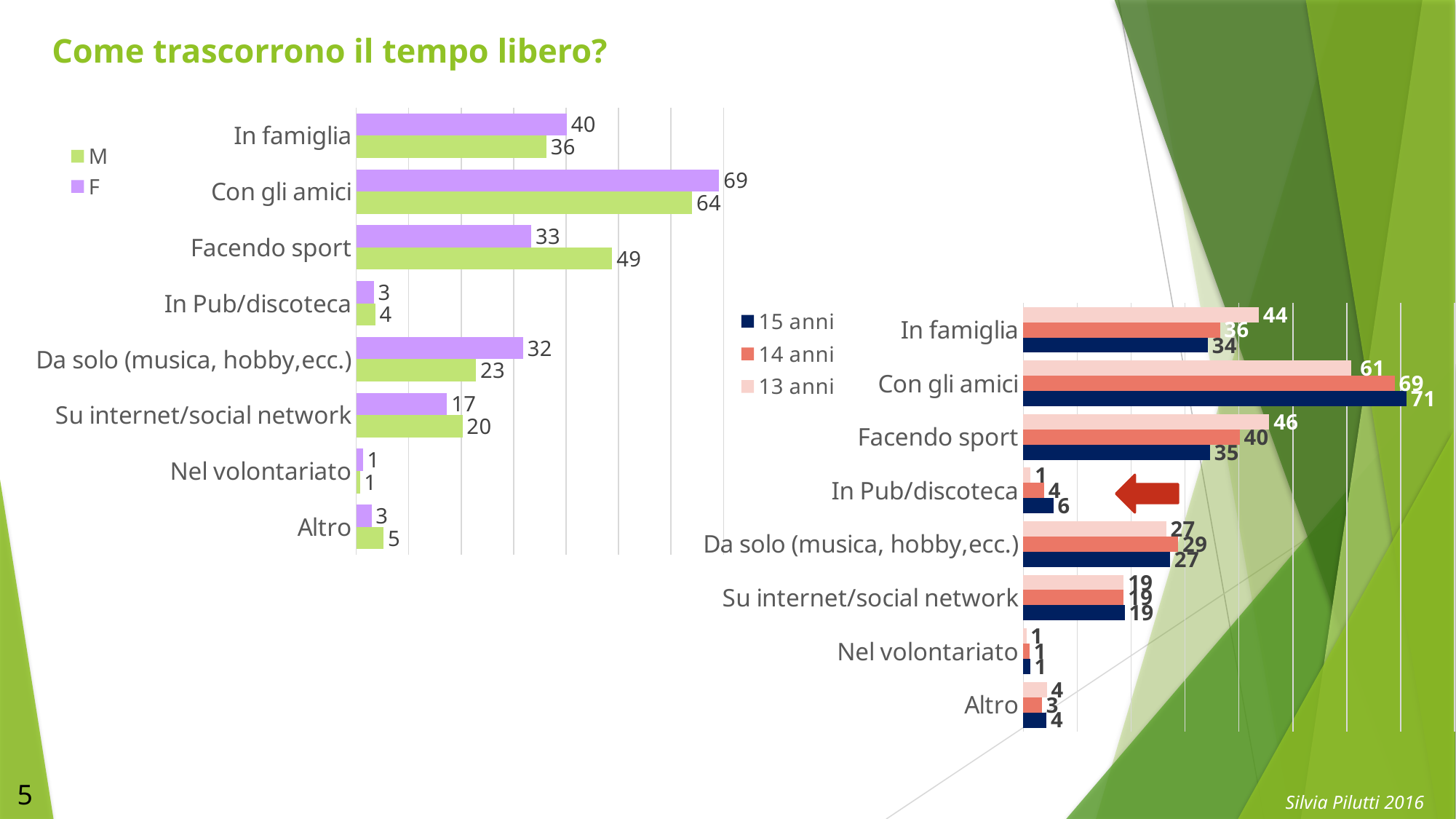
In the left chart, which is larger for 'Su internet/social network', M or F? M In the right chart, what is the value for 15 anni for 'Con gli amici'? 71 In the left chart, what is the value for F for 'Facendo sport'? 33 In the right chart, what is the value for 13 anni for 'In famiglia'? 44 How many series does the legend of the left chart list? 2 What type of chart is the right chart? Bar chart In the right chart, which age group has the highest value for 'Facendo sport'? 13 anni In the left chart, what is the difference between M and F for 'Facendo sport'? 16 In the left chart, which category has the highest value for F? Con gli amici How many categories does the right chart show? 8 In the left chart, what is the value for M for 'Da solo (musica, hobby,ecc.)'? 23 In the right chart, what is the difference between 15 anni and 13 anni for 'In Pub/discoteca'? 5